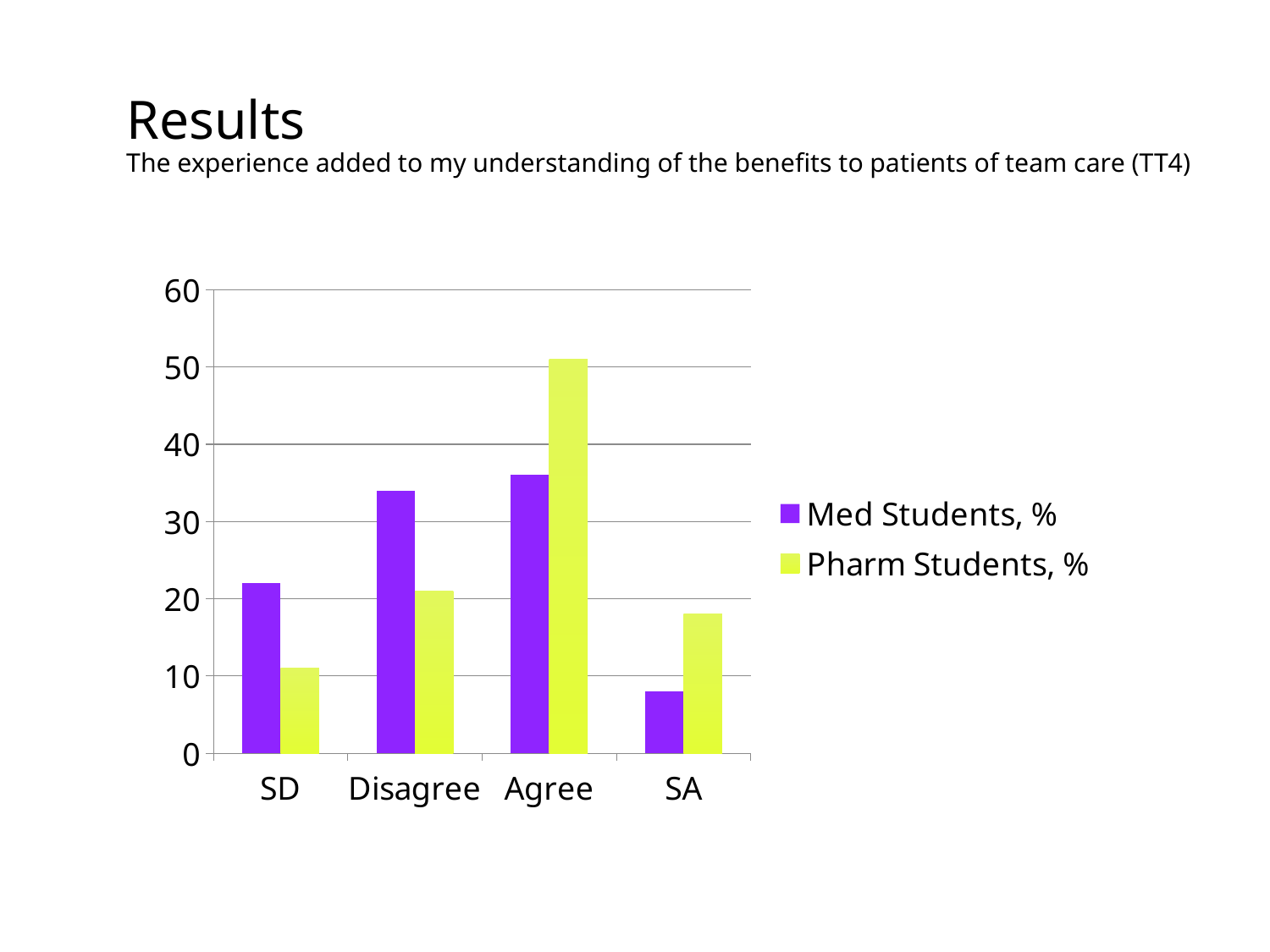
Which category has the highest value for Pharm Students, %? Agree How many categories are shown on the x axis? 4 Is the value for Pharm Students, % in the SD category greater or less than 20? less For the SD category, which series has the larger value, Med Students, % or Pharm Students, %? Med Students, % What kind of chart is shown on the slide? bar chart Is the value for Pharm Students, % in the Agree category greater or less than 40? greater Which category has the lowest value for Med Students, %? SA Which category has the lowest value for Pharm Students, %? SD Is the value for Med Students, % in the SA category greater or less than 10? less For the Agree category, which series has the larger value, Med Students, % or Pharm Students, %? Pharm Students, % Which series is shown in purple in the legend? Med Students, % How many series does the legend list? 2